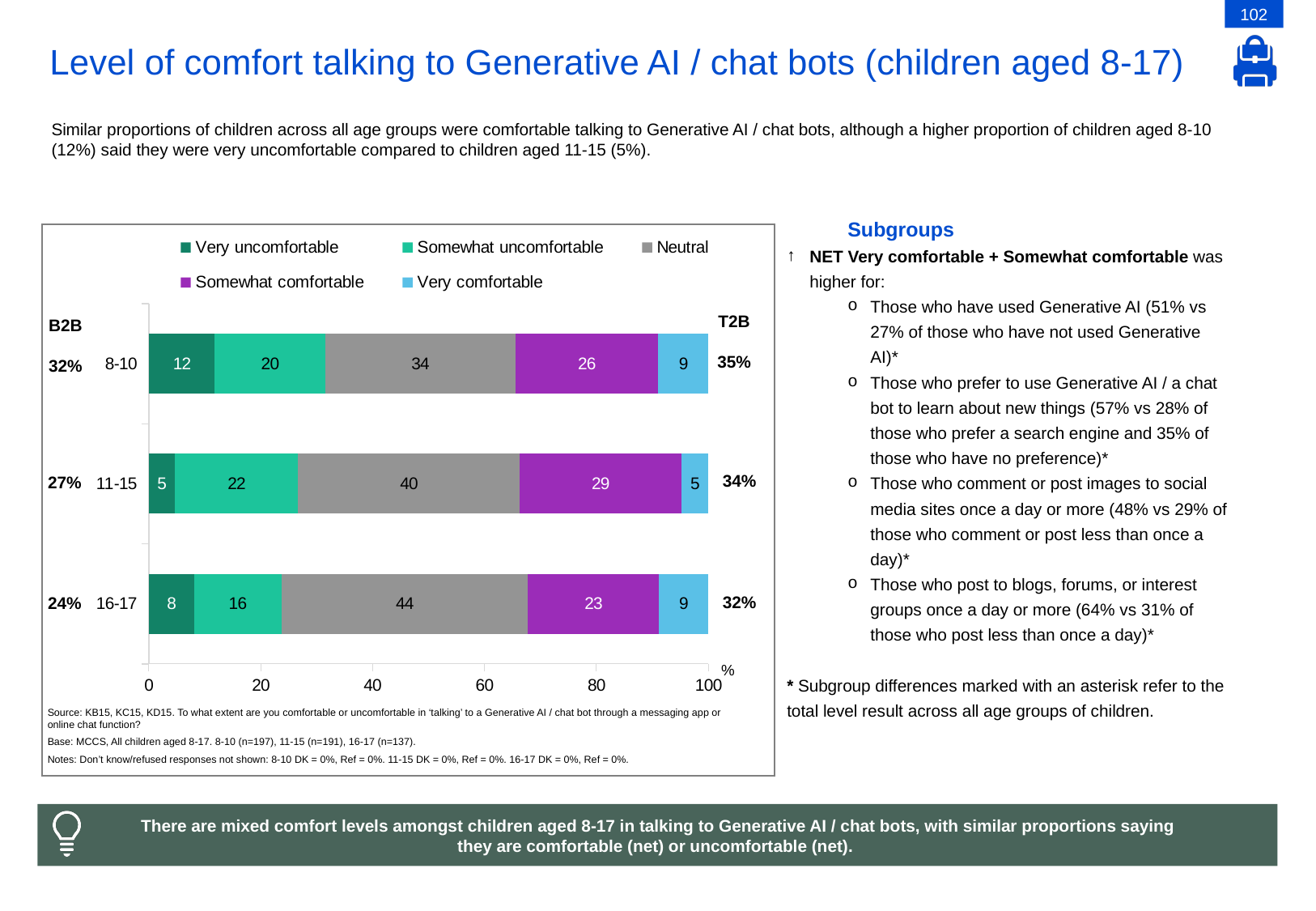
What is the B2B value shown for children aged 16-17? 24% How many age groups are plotted in the chart? 3 Which age group has the lowest Very uncomfortable value? 11-15 What is the difference between the Somewhat uncomfortable values for 11-15 and 16-17? 6 What kind of chart is shown on the slide? Stacked bar chart What is the Somewhat comfortable value for children aged 11-15? 29 What is the T2B value shown for children aged 8-10? 35% How many series does the chart legend list? 5 Which is larger: the Somewhat comfortable value for 8-10 or for 16-17? 8-10 What is the Very uncomfortable value for children aged 8-10? 12 What is the Neutral value for children aged 16-17? 44 Which age group has the highest Neutral value? 16-17